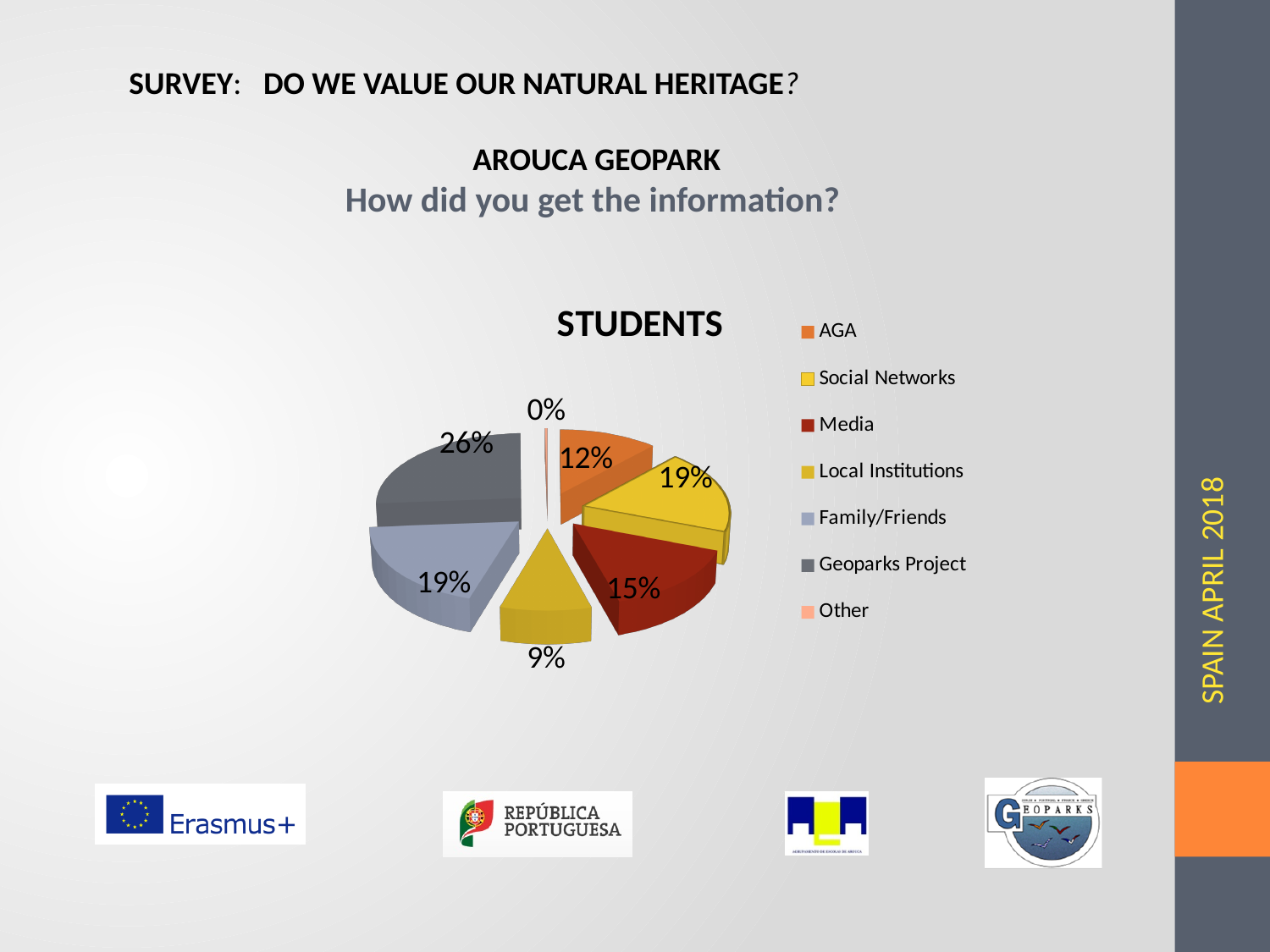
What share of the pie does Local Institutions have? 9% Which is larger, the share for Media or the share for Local Institutions? Media What kind of chart is shown on the slide? pie chart Which category has the largest share of the pie? Geoparks Project Which category has the smallest share of the pie? Other What share of the pie does Media have? 15% What share of the pie does Geoparks Project have? 26% What is the title of the chart? STUDENTS What share of the pie does Other have? 0% How many categories does the legend of the pie chart list? 7 What share of the pie does AGA have? 12% What is the difference between the shares of Geoparks Project and Media? 11%